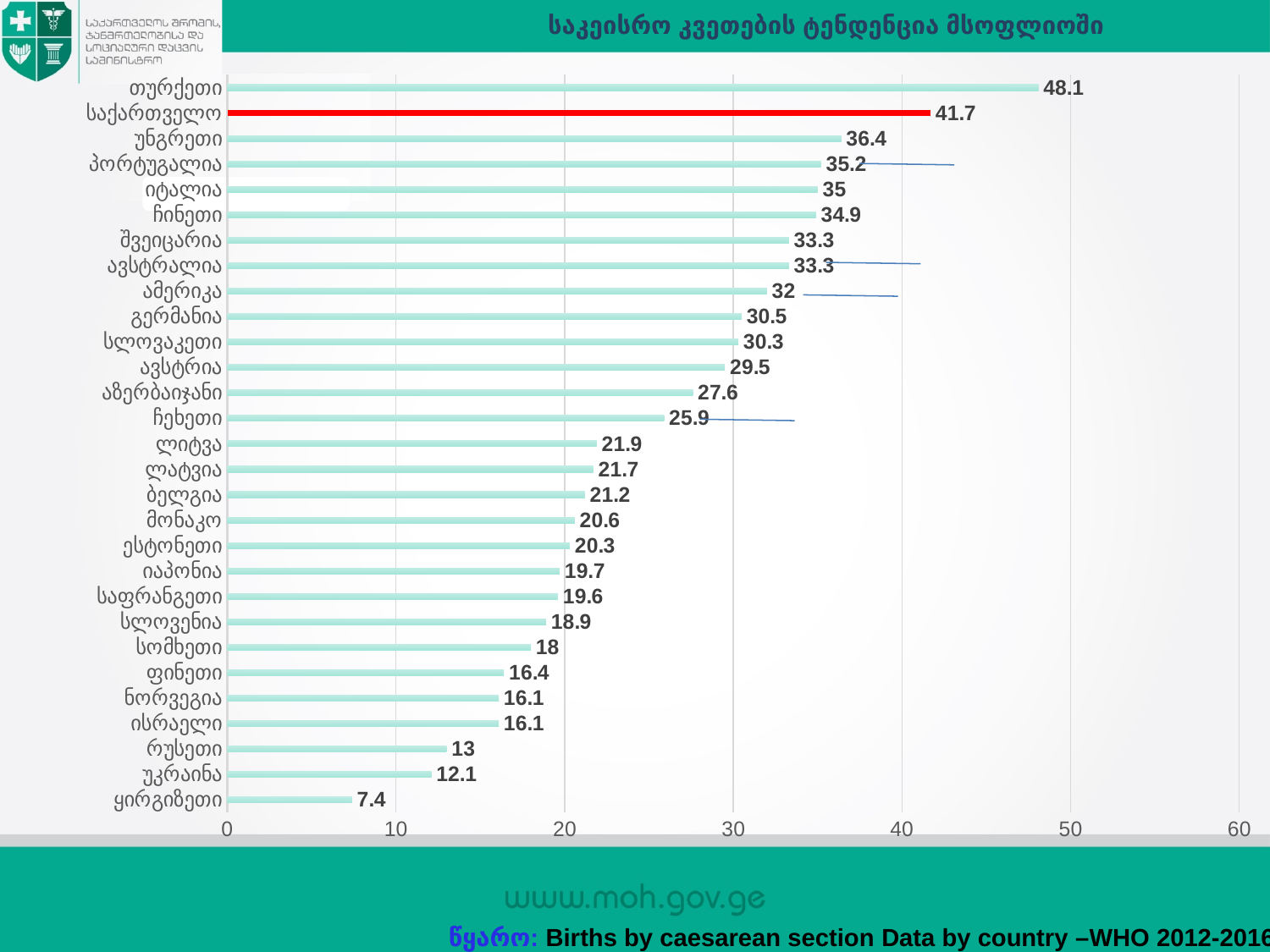
What is the value for აზერბაიჯანი? 27.6 What kind of chart is shown on the slide? bar chart What is the difference between the values for თურქეთი and საქართველო? 6.4 What is the value for ყირგიზეთი? 7.4 What is the value for საქართველო? 41.7 What is the value for თურქეთი? 48.1 Which has a larger value, უნგრეთი or გერმანია? უნგრეთი Which bar is highlighted in red? საქართველო Which country has the highest value? თურქეთი How many countries are shown in the chart? 29 Is the value for ჩეხეთი greater or less than 30? less Which country has the lowest value? ყირგიზეთი